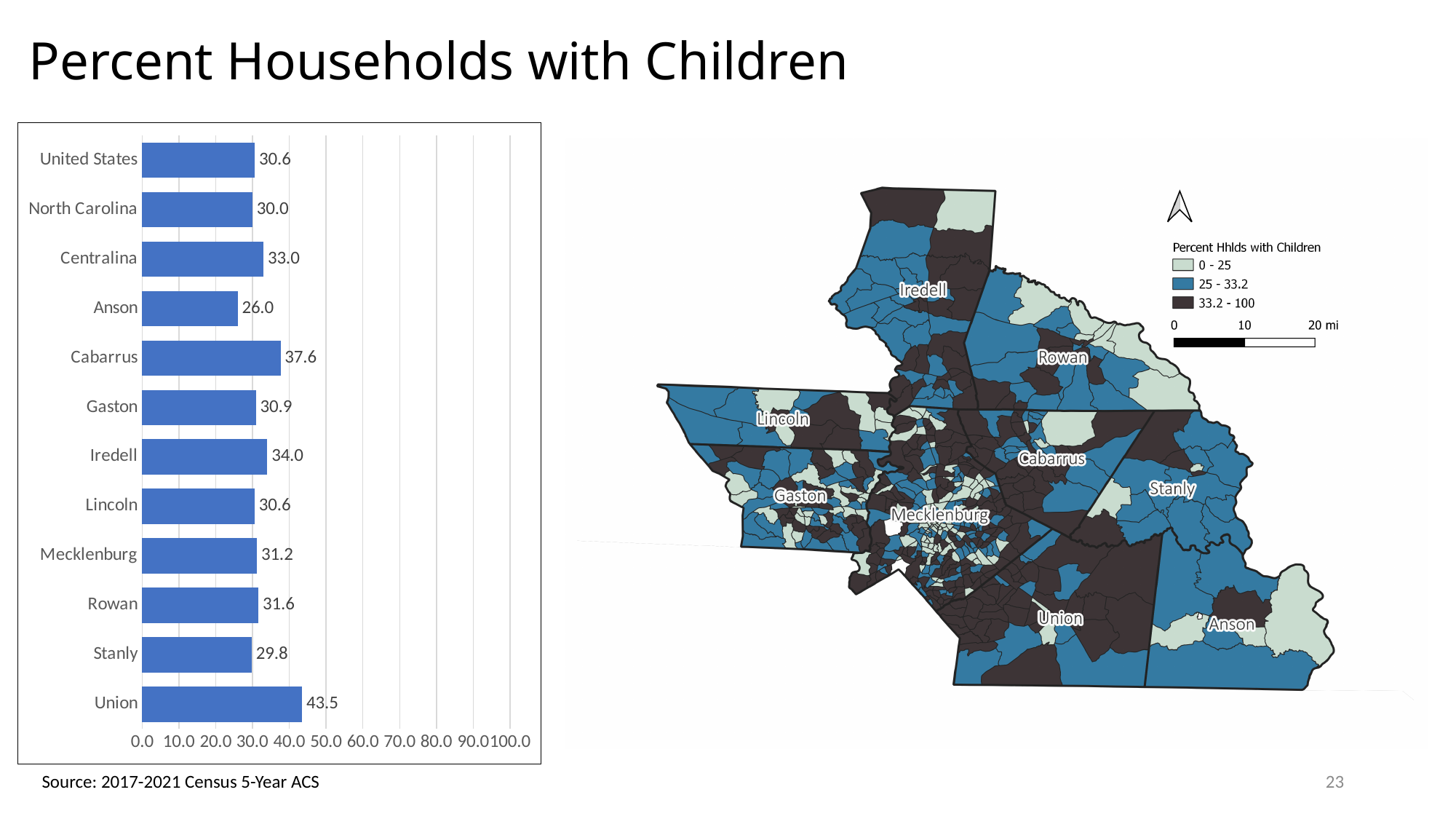
What kind of chart is shown on the left of the slide? bar chart Is the value for Cabarrus in the bar chart greater or less than 30.0? greater Which category has the lowest value in the bar chart? Anson How many categories are shown in the bar chart? 12 Which has a larger value in the bar chart, Iredell or Mecklenburg? Iredell What is the value for Union in the bar chart? 43.5 Which category has the highest value in the bar chart? Union What is the value for Centralina in the bar chart? 33.0 What is the value for Anson in the bar chart? 26.0 What is the difference between the values for Union and Anson in the bar chart? 17.5 What is the title of the slide? Percent Households with Children What is the difference between the values for Cabarrus and Gaston in the bar chart? 6.7